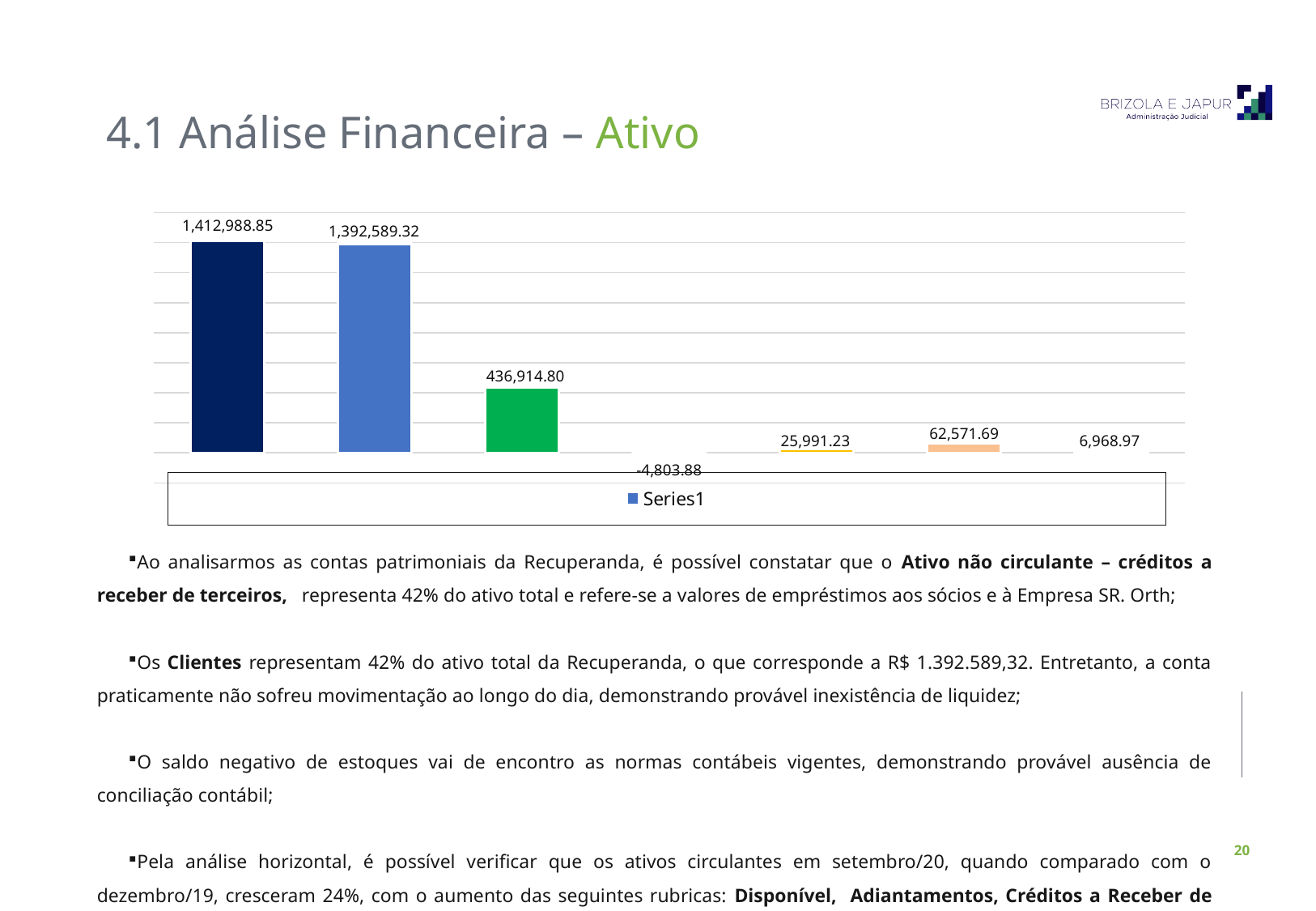
Which is larger: the value 62,571.69 or the value 25,991.23 shown in the chart? 62,571.69 What is the value of the leftmost (first) bar in the chart? 1,412,988.85 What is the name of the series shown in the chart legend? Series1 What is the lowest value shown in the chart? -4,803.88 What is the value of the rightmost bar in the chart? 6,968.97 What is the highest value shown in the chart? 1,412,988.85 What is the value of the second bar from the left in the chart? 1,392,589.32 What is the value of the third bar from the left (the green bar) in the chart? 436,914.80 How many bars are plotted in the chart? 7 How many series does the chart legend list? 1 What is the difference between the first bar (1,412,988.85) and the second bar (1,392,589.32)? 20,399.53 What type of chart is shown on the slide? bar chart